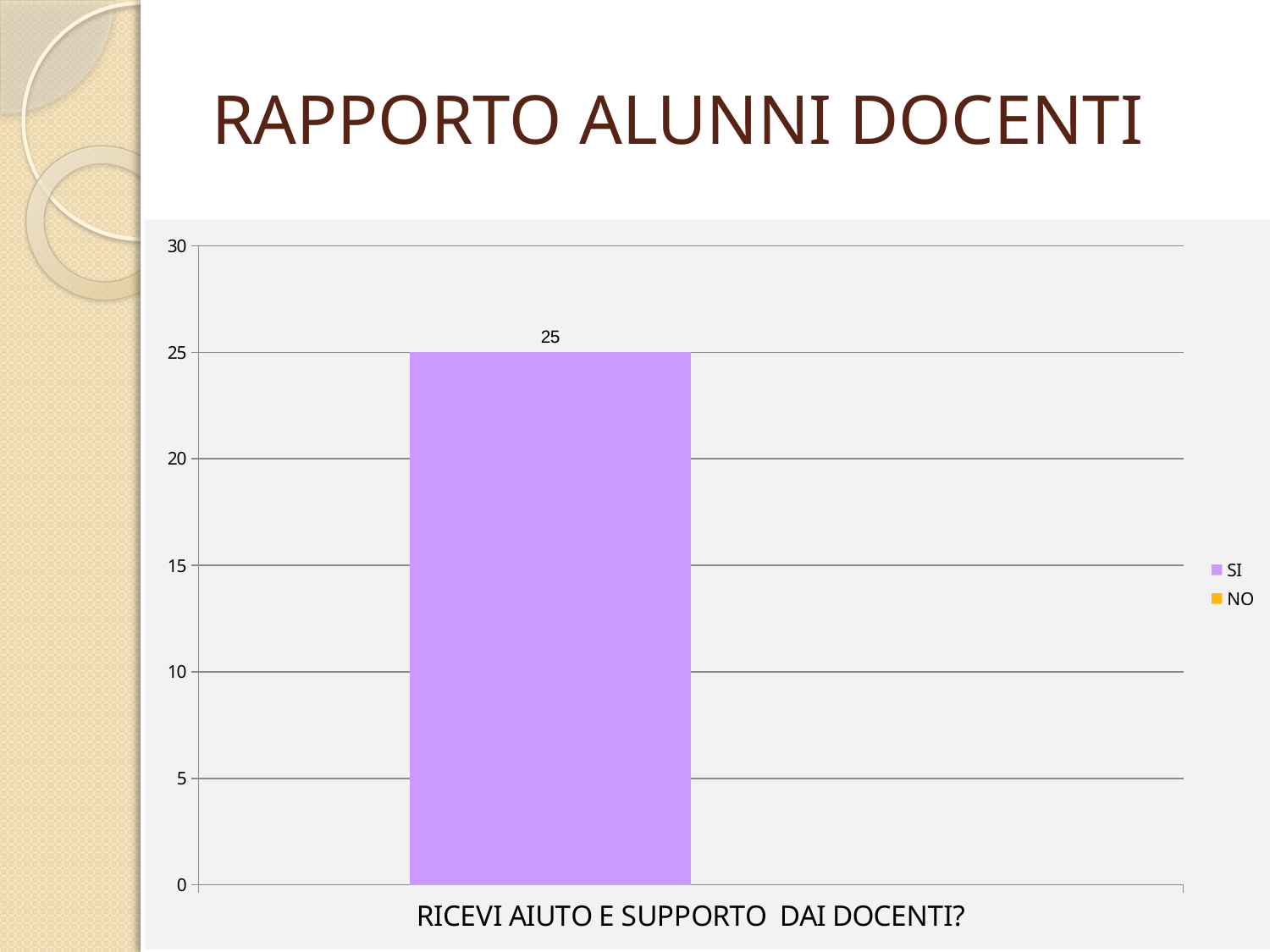
What are the two entries listed in the legend? SI and NO What is the category label shown on the x axis? RICEVI AIUTO E SUPPORTO DAI DOCENTI? What kind of chart is shown on the slide? bar chart What is the value of the SI series for the category "RICEVI AIUTO E SUPPORTO DAI DOCENTI?"? 25 Which series has the highest value in the chart? SI Is the value for SI greater or less than 20? greater Which series has the larger value, SI or NO? SI How many categories are shown on the x axis? 1 How many series does the legend list? 2 Is the value for SI greater or less than 30? less